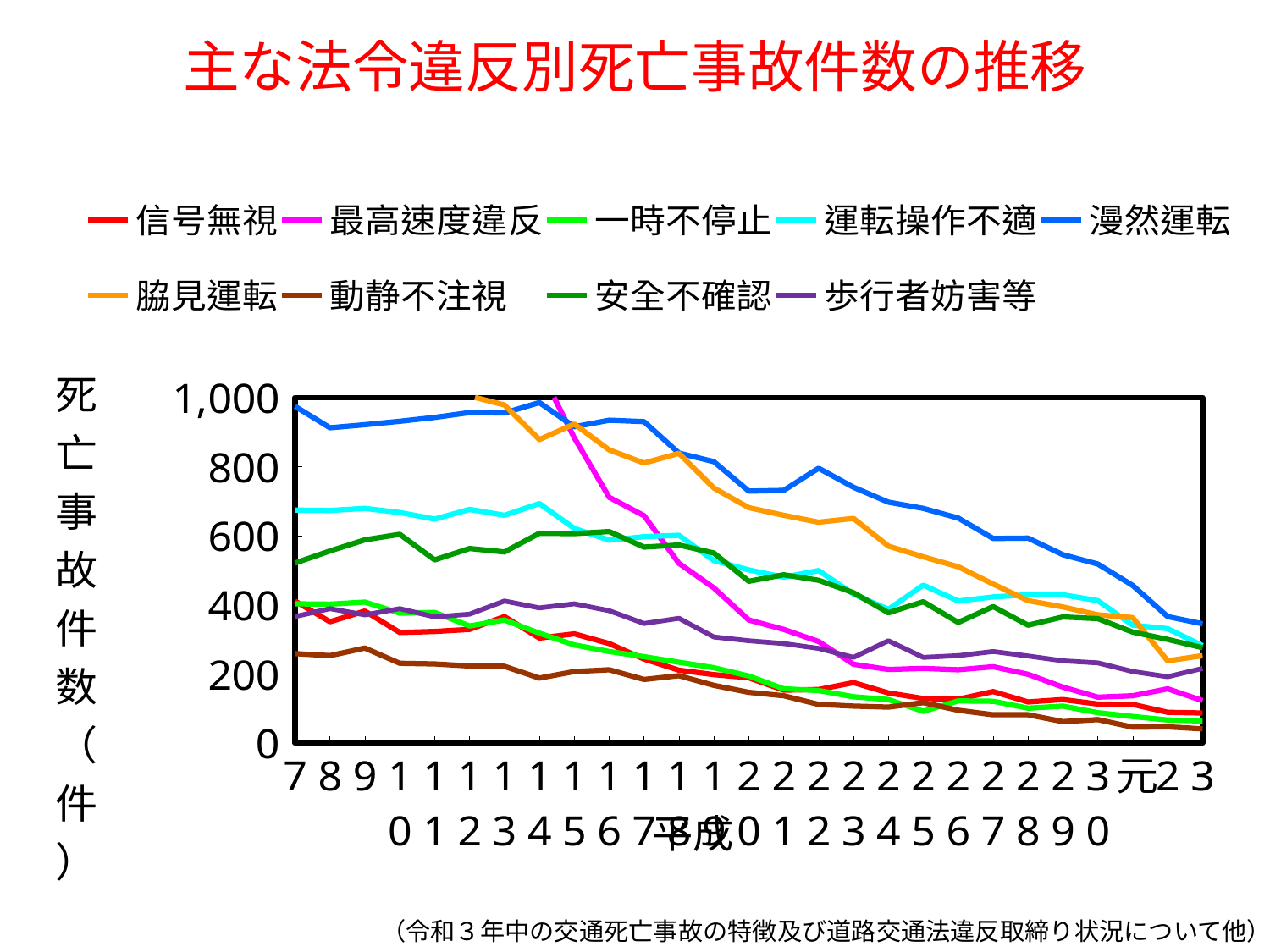
Does the 漫然運転 series generally rise or fall from 平成7 to 令和3? fall Is the value for 最高速度違反 in 令和3 greater or less than 200? less Which is larger in 平成7, the value for 漫然運転 or the value for 信号無視? 漫然運転 Is the value for 運転操作不適 in 平成7 greater or less than 600? greater Is the value for 動静不注視 in 平成7 greater or less than 200? greater What kind of chart is shown on the slide? line chart Which colour is used for the 信号無視 series? red What is the title of the chart? 主な法令違反別死亡事故件数の推移 Which series has the highest value in 令和3? 漫然運転 Which is larger in 令和3, the value for 漫然運転 or the value for 動静不注視? 漫然運転 How many series does the legend list? 9